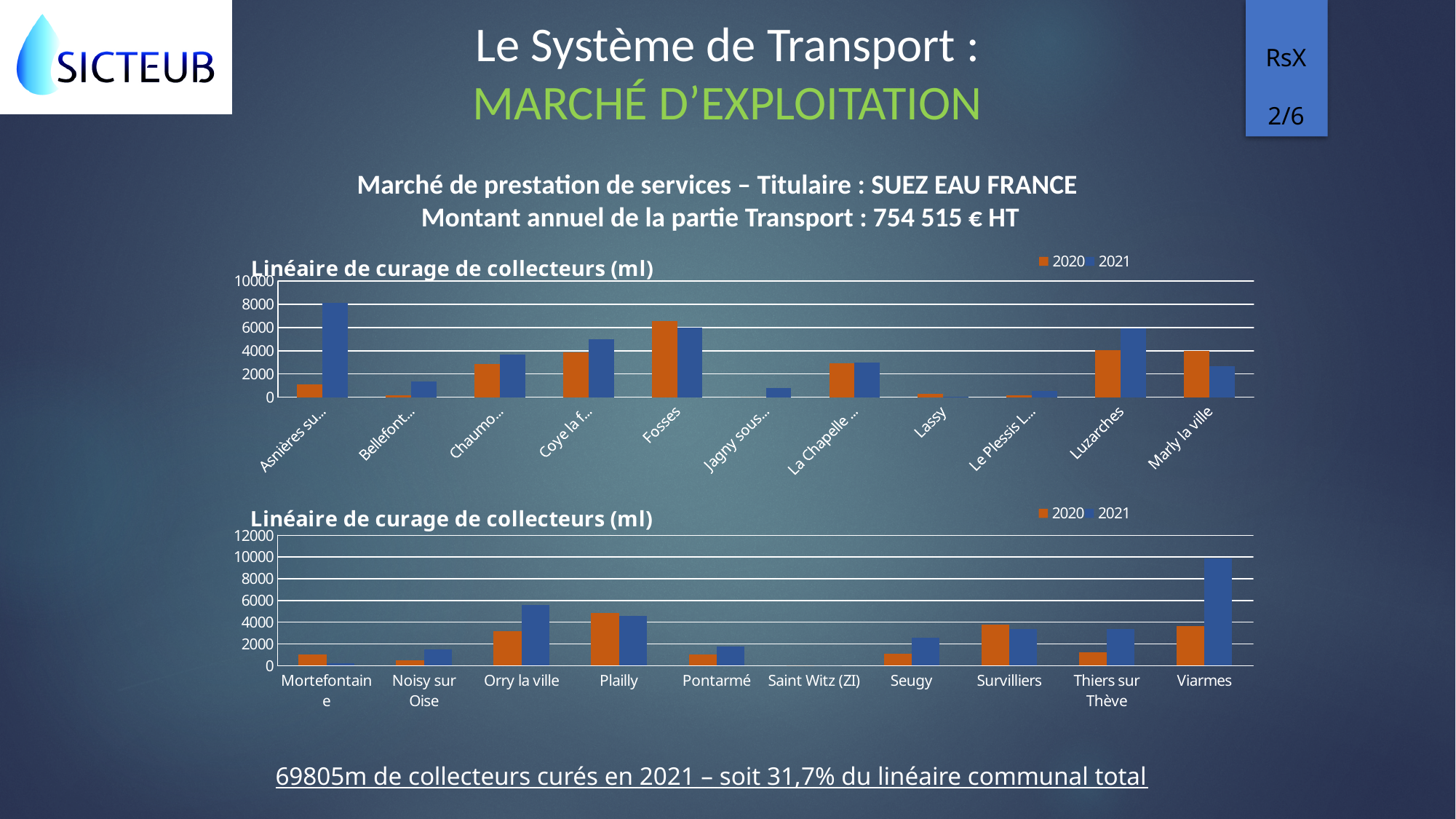
On the top chart, is the 2021 value for Luzarches greater or less than 4000? greater On the bottom chart, is the 2021 value for Viarmes greater or less than 8000? greater How many series does the legend of the top chart list? 2 On the top chart, is the 2021 value for Fosses greater or less than 4000? greater On the bottom chart, which year has the larger value for Viarmes, 2020 or 2021? 2021 On the top chart, which category has the highest value for 2020? Fosses On the top chart, which year has the larger value for Marly la ville, 2020 or 2021? 2020 How many categories are shown on the bottom chart? 10 On the bottom chart, which category has the highest value for 2021? Viarmes What kind of chart is the top chart? bar chart